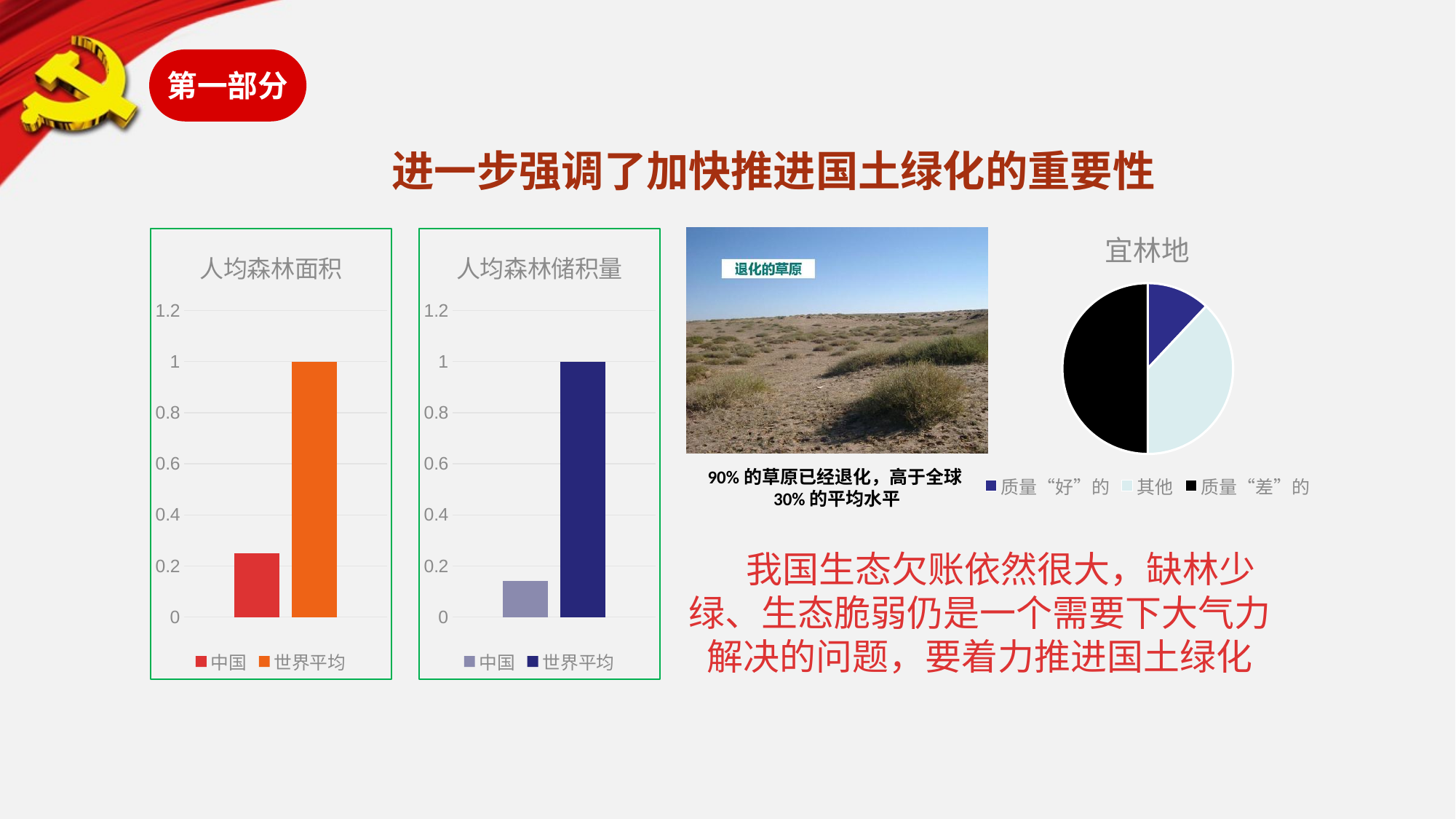
In the 人均森林储积量 chart, is the value for 中国 greater or less than 0.2? less How many categories does the legend of the 宜林地 pie chart list? 3 How many series does the legend of the 人均森林面积 chart list? 2 What kind of chart is the 人均森林储积量 chart? bar chart In the 人均森林储积量 chart, what is the value for 世界平均? 1 What kind of chart is the 宜林地 chart? pie chart In the 人均森林面积 chart, is the value for 中国 greater or less than 0.2? greater In the 人均森林储积量 chart, which series has the lowest value? 中国 In the 人均森林面积 chart, which series has the higher value, 中国 or 世界平均? 世界平均 In the 人均森林面积 chart, is the value for 中国 greater or less than 0.4? less In the 人均森林面积 chart, what is the value for 世界平均? 1 In the 宜林地 pie chart, which category has the largest slice? 质量“差”的